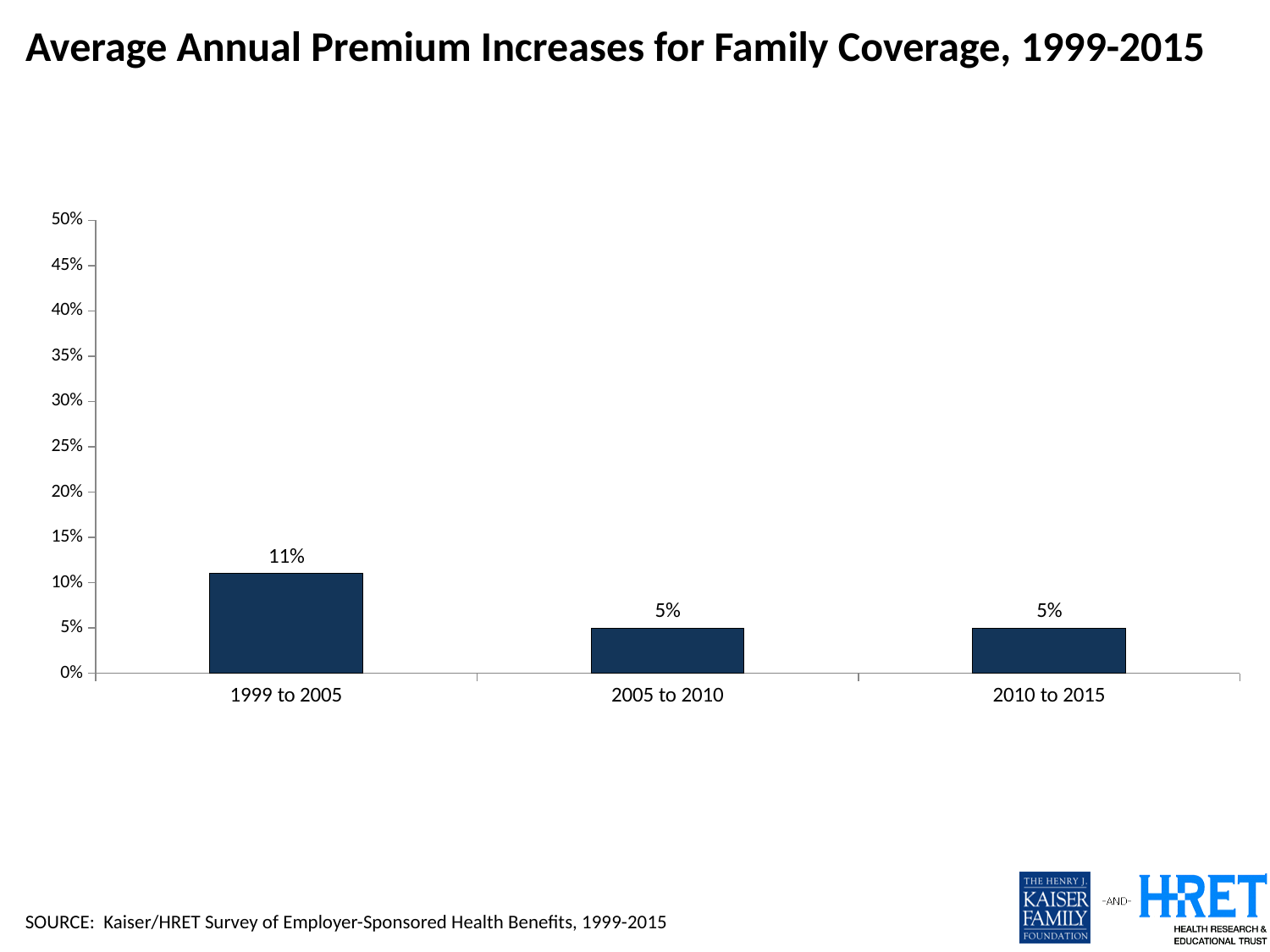
What is the title of the chart? Average Annual Premium Increases for Family Coverage, 1999-2015 What is the average annual premium increase for 1999 to 2005? 11% What is the average annual premium increase for 2005 to 2010? 5% What is the difference between the average annual premium increase for 1999 to 2005 and for 2005 to 2010? 6% Which period has the highest average annual premium increase? 1999 to 2005 What kind of chart is shown on the slide? Bar chart Is the value for 2005 to 2010 greater or less than 10%? less Which is larger, the value for 1999 to 2005 or the value for 2010 to 2015? 1999 to 2005 Is the value for 1999 to 2005 greater or less than 10%? greater What is the average annual premium increase for 2010 to 2015? 5% Do the values rise or fall from 1999 to 2005 to 2005 to 2010? Fall How many periods are shown on the chart? 3